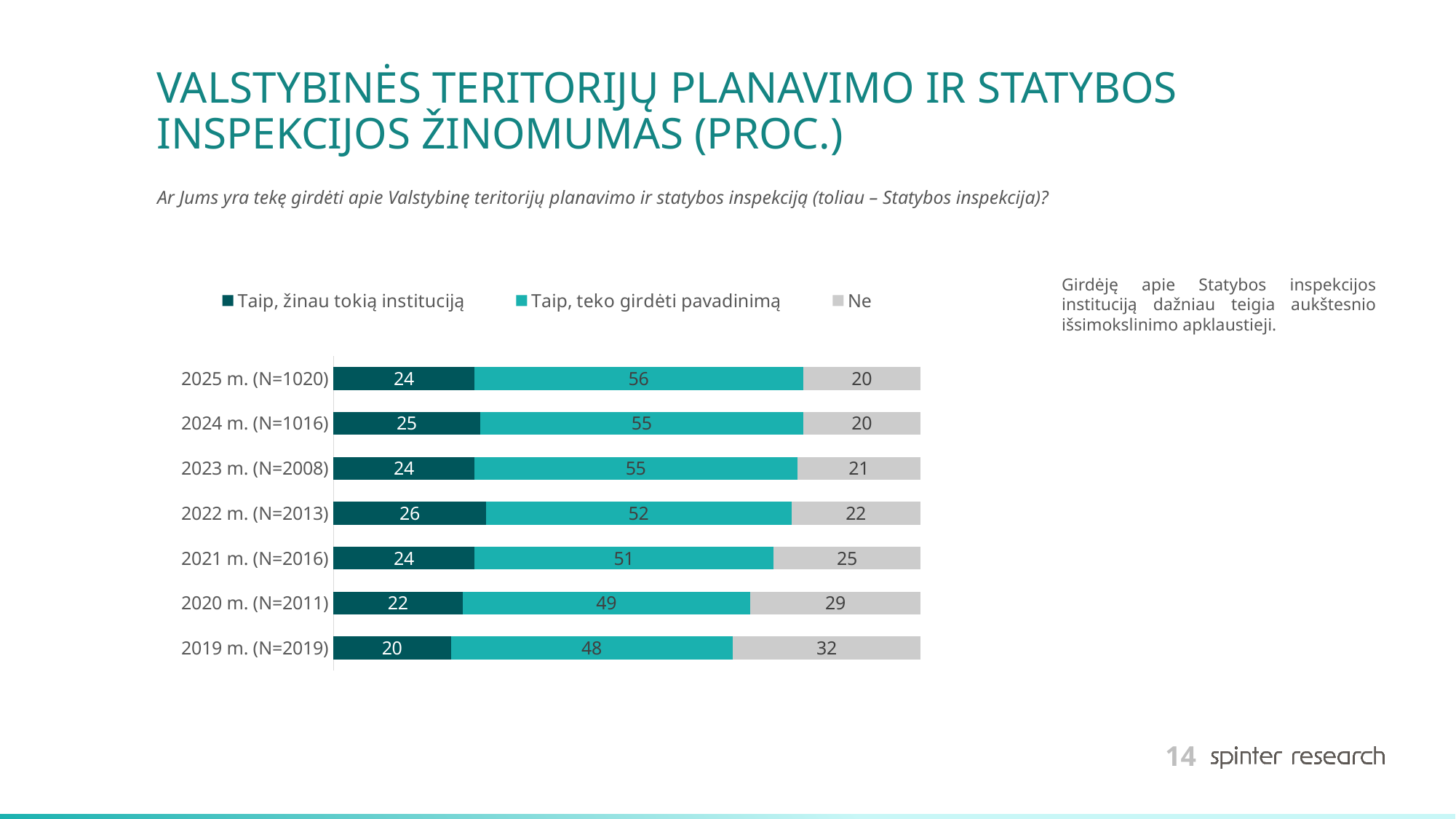
What is the value for "Taip, žinau tokią instituciją" in 2022 m. (N=2013)? 26 What is the value for "Taip, teko girdėti pavadinimą" in 2025 m. (N=1020)? 56 What is the difference between the "Ne" values for 2019 m. (N=2019) and 2025 m. (N=1020)? 12 What kind of chart is shown on the slide? Stacked bar chart How many series does the legend list? 3 Which is larger: the "Taip, teko girdėti pavadinimą" value for 2020 m. (N=2011) or for 2021 m. (N=2016)? 2021 m. (N=2016) What is the total of the stacked bar for 2023 m. (N=2008)? 100 What is the value for "Ne" in 2019 m. (N=2019)? 32 Which year has the lowest value for "Taip, žinau tokią instituciją"? 2019 m. (N=2019) Does the "Ne" value rise or fall from 2019 to 2025? Fall How many years (categories) are shown in the chart? 7 Which year has the highest value for "Ne"? 2019 m. (N=2019)